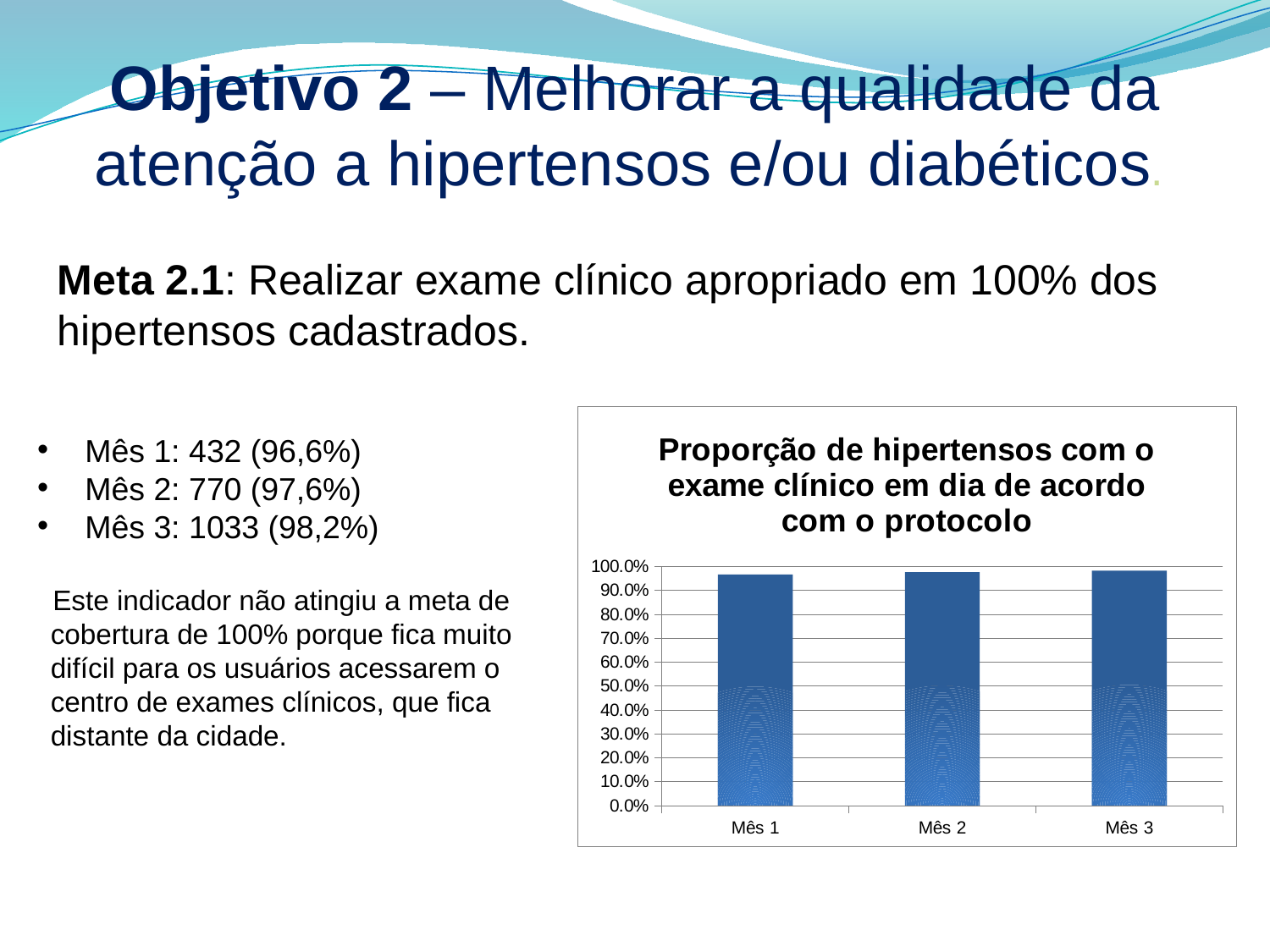
What is the highest tick value shown on the vertical axis of the chart? 100.0% Is the value for Mês 2 greater or less than 50.0%? greater Is the value for Mês 1 greater or less than 90.0%? greater According to the slide, what proportion is reported for Mês 2? 97,6% What is the title of the chart on the slide? Proporção de hipertensos com o exame clínico em dia de acordo com o protocolo Do the values rise or fall from Mês 1 to Mês 3? rise According to the slide, what proportion is reported for Mês 3? 98,2% How many categories (months) are plotted on the chart? 3 Is the value for Mês 1 greater or less than 80.0%? greater What kind of chart is shown on the slide? bar chart According to the slide, what proportion is reported for Mês 1? 96,6%